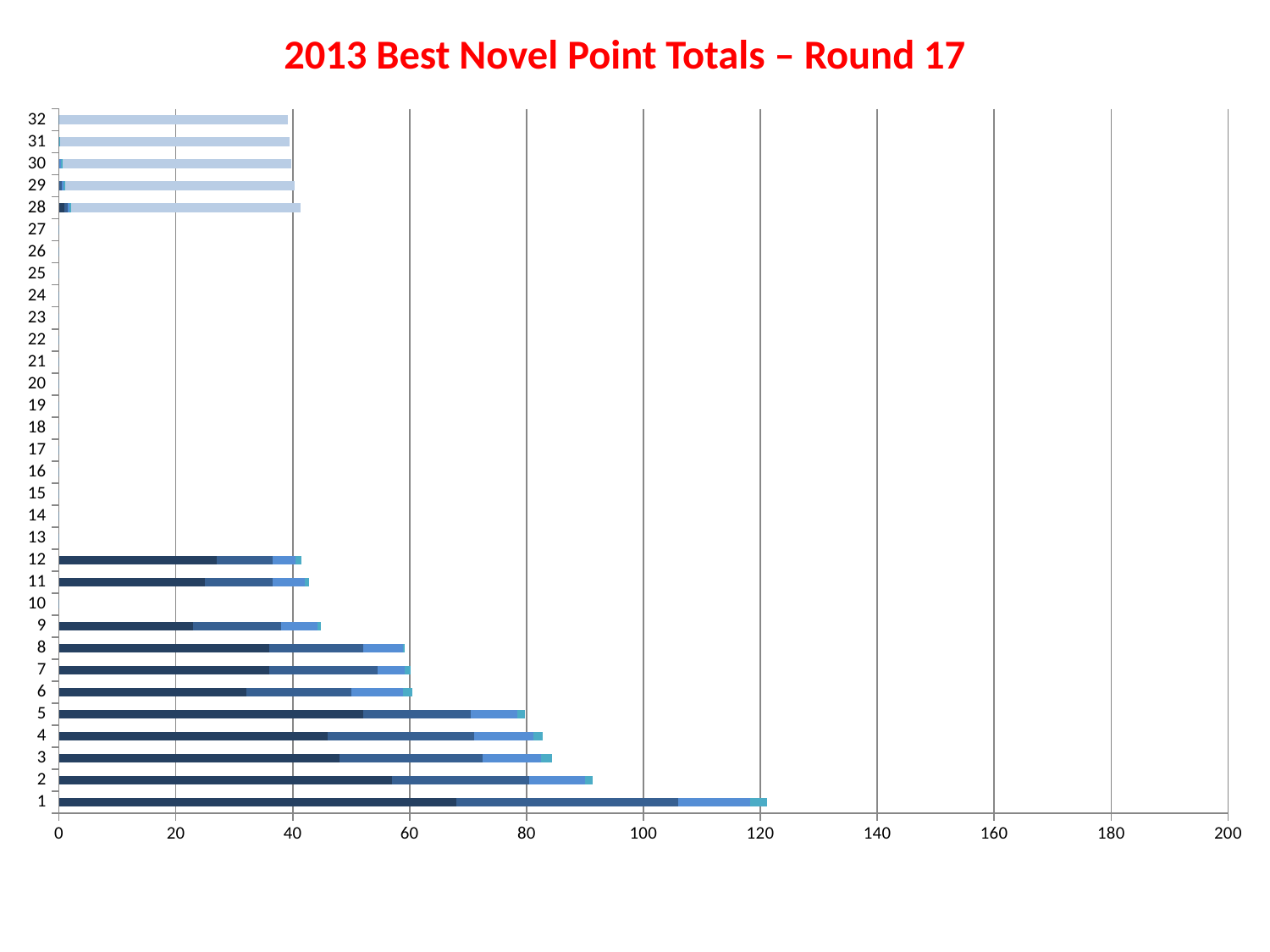
Which category has the highest total in the chart? 1 Is the total for category 2 greater or less than 100? less Which has the larger total, category 8 or category 9? 8 Is the total for category 9 greater or less than 60? less Which has the larger total, category 1 or category 2? 1 What is the title of the chart? 2013 Best Novel Point Totals – Round 17 How many categories are listed on the vertical axis of the chart? 32 Is the total for category 8 greater or less than 40? greater What kind of chart is shown on the slide? bar chart What is the highest value shown on the horizontal axis? 200